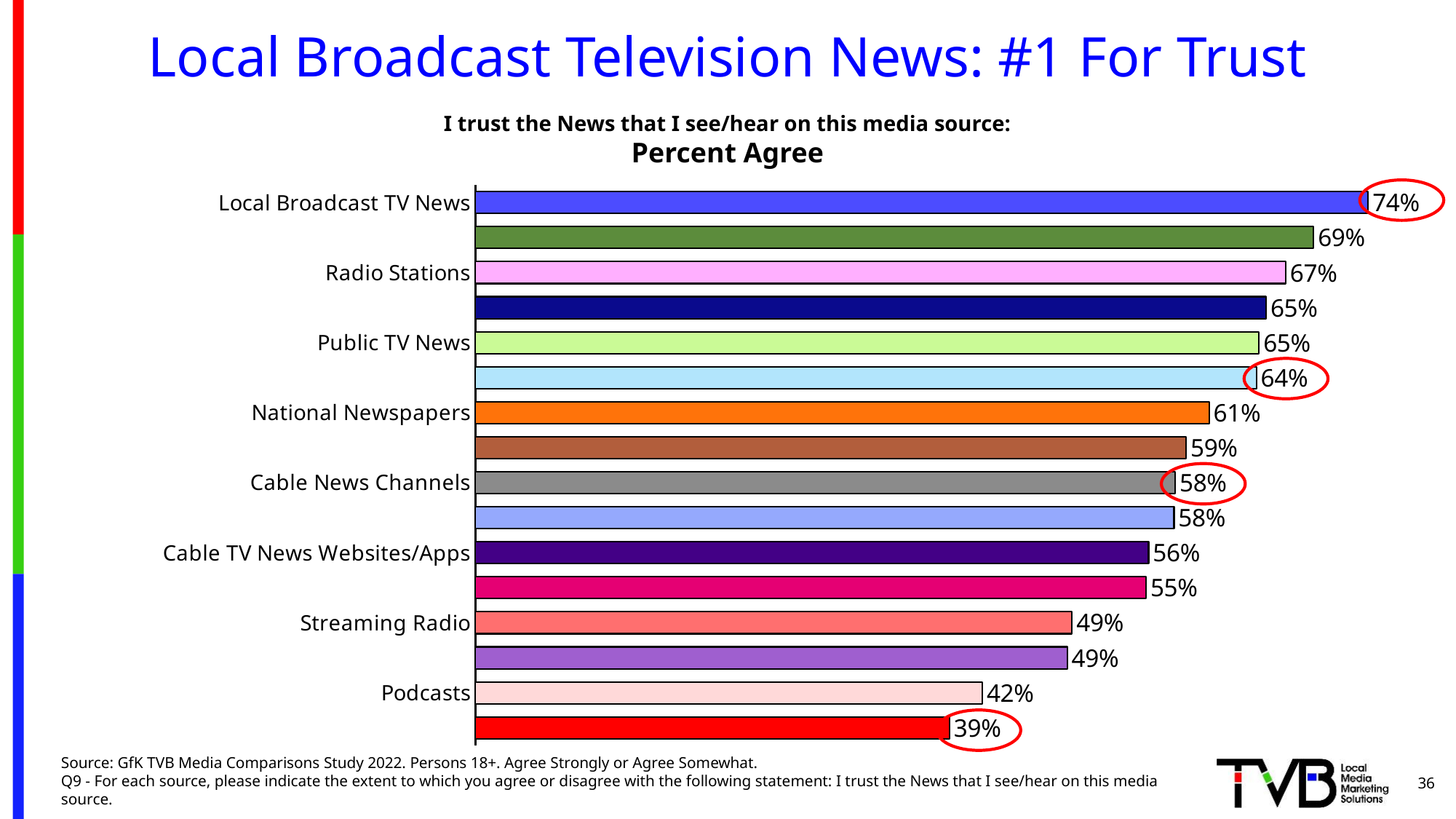
Which media source has the highest percent agree? Local Broadcast TV News What percentage agree that they trust the news on Local Broadcast TV News? 74% What is the value shown for Podcasts? 42% What statement were respondents asked to agree with, according to the chart heading? I trust the News that I see/hear on this media source What kind of chart is shown on the slide? Bar chart Which has a higher percent agree, Public TV News or National Newspapers? Public TV News What is the value shown for Cable News Channels? 58% What is the value shown for Streaming Radio? 49% What is the difference in percentage points between Local Broadcast TV News and Podcasts? 32 percentage points What is the lowest percent agree value shown on the chart? 39% How many bars are plotted on the chart? 16 What is the value shown for Radio Stations? 67%